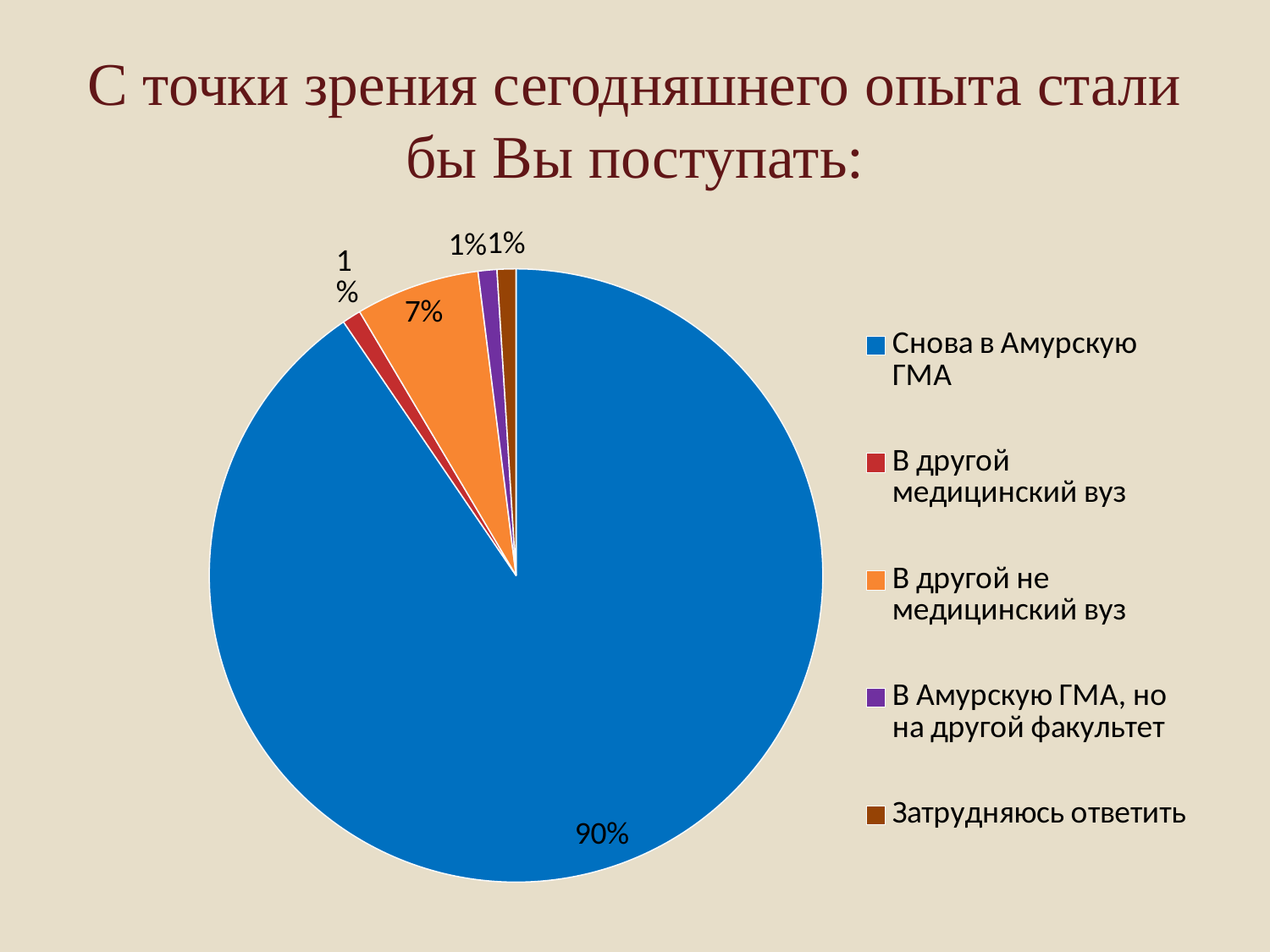
What is the value for "В другой не медицинский вуз"? 7% What is the value for "Затрудняюсь ответить"? 1% What kind of chart is shown on the slide? pie chart How many categories does the pie chart have? 5 What is the value for "В Амурскую ГМА, но на другой факультет"? 1% What colour is the slice for "Снова в Амурскую ГМА"? blue Which is larger: the value for "В другой не медицинский вуз" or the value for "В другой медицинский вуз"? В другой не медицинский вуз What share of the pie does "Снова в Амурскую ГМА" take? 90% Which category has the largest slice of the pie? Снова в Амурскую ГМА What is the title of the slide? С точки зрения сегодняшнего опыта стали бы Вы поступать: What is the value for "В другой медицинский вуз"? 1% What is the difference between the values for "Снова в Амурскую ГМА" and "В другой не медицинский вуз"? 83%